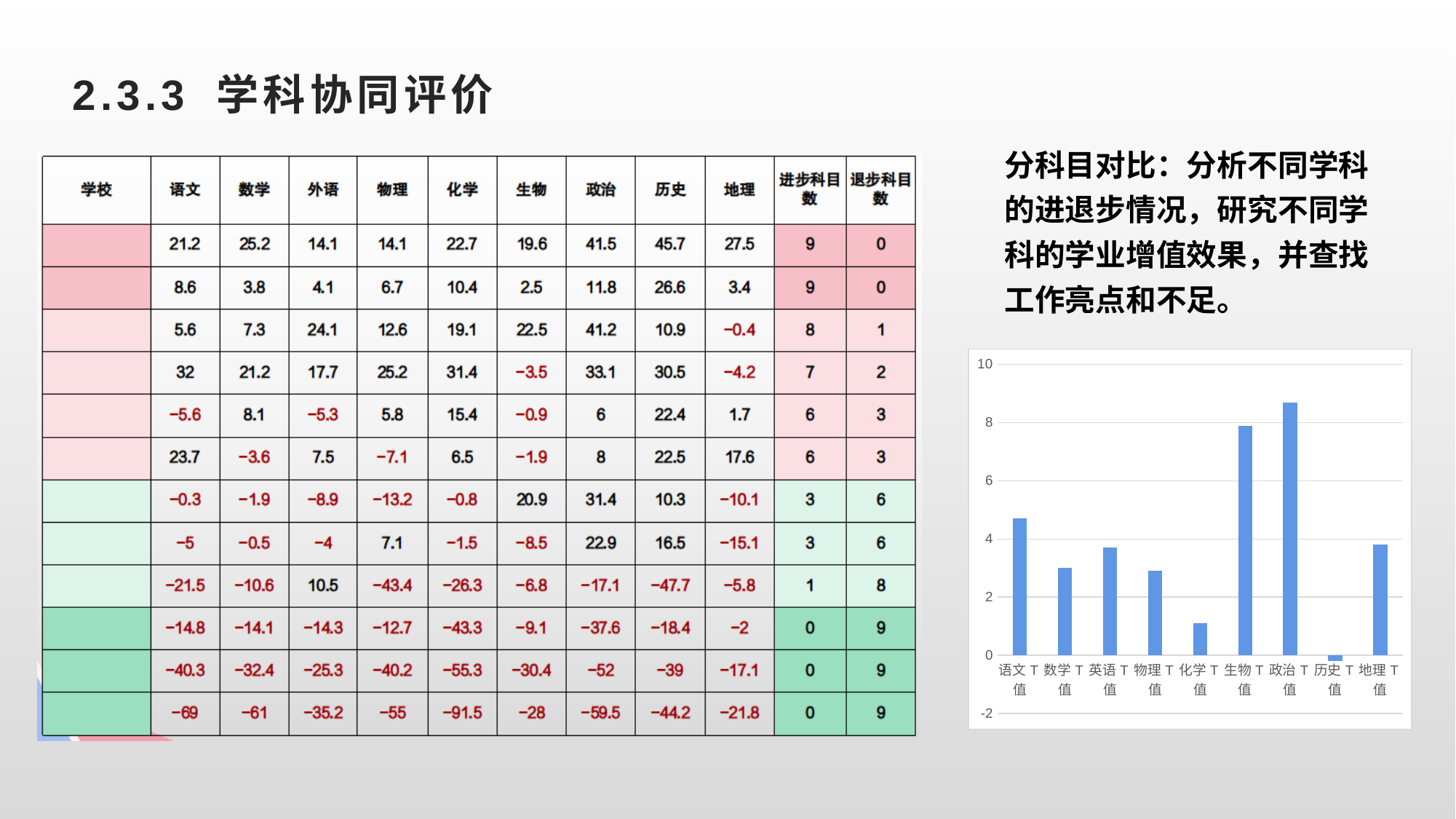
How many categories are plotted in the bar chart? 9 In the bar chart, which is larger, the value for 化学 T值 or the value for 地理 T值? 地理 T值 In the bar chart, is the value for 语文 T值 greater or less than 4? greater In the bar chart, is the value for 政治 T值 greater or less than 8? greater In the bar chart, is the value for 历史 T值 greater or less than 0? less In the bar chart, which is larger, the value for 生物 T值 or the value for 语文 T值? 生物 T值 In the bar chart, which category has the highest value? 政治 T值 In the bar chart, which category has the lowest value? 历史 T值 What kind of chart is shown on the right side of the slide? bar chart What is the highest value shown on the vertical axis of the bar chart? 10